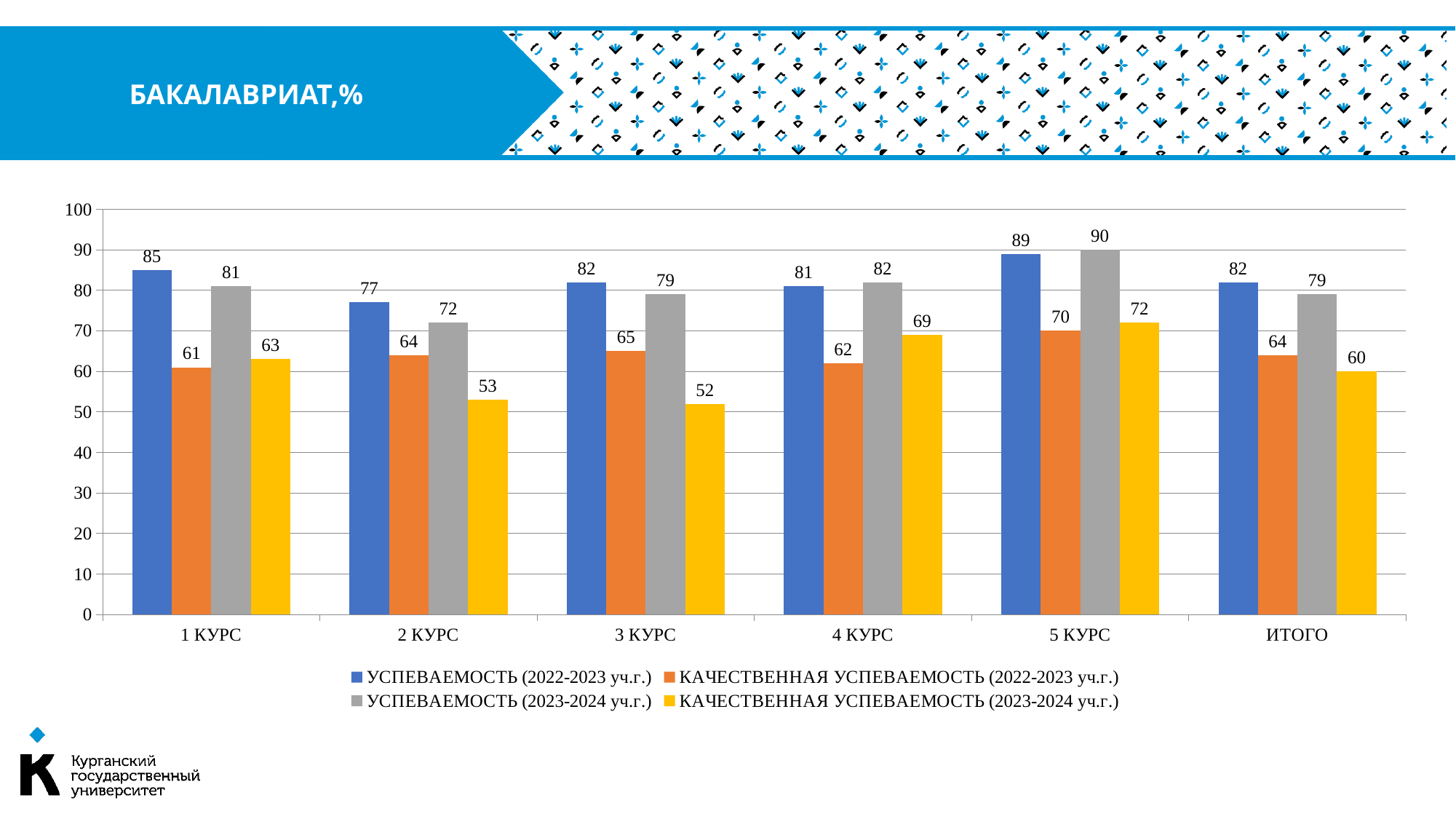
What is the value of КАЧЕСТВЕННАЯ УСПЕВАЕМОСТЬ (2023-2024 уч.г.) for 3 КУРС? 52 What is the title of the slide? БАКАЛАВРИАТ,% For 4 КУРС, which is larger: КАЧЕСТВЕННАЯ УСПЕВАЕМОСТЬ (2022-2023 уч.г.) or КАЧЕСТВЕННАЯ УСПЕВАЕМОСТЬ (2023-2024 уч.г.)? КАЧЕСТВЕННАЯ УСПЕВАЕМОСТЬ (2023-2024 уч.г.) Which category has the highest value for УСПЕВАЕМОСТЬ (2023-2024 уч.г.)? 5 КУРС What is the difference between УСПЕВАЕМОСТЬ (2022-2023 уч.г.) and КАЧЕСТВЕННАЯ УСПЕВАЕМОСТЬ (2022-2023 уч.г.) for 2 КУРС? 13 What is the value of УСПЕВАЕМОСТЬ (2023-2024 уч.г.) for ИТОГО? 79 How many series does the legend list? 4 Which category has the lowest value for КАЧЕСТВЕННАЯ УСПЕВАЕМОСТЬ (2023-2024 уч.г.)? 3 КУРС What type of chart is shown on the slide? bar chart How many categories are shown on the x axis? 6 What is the value of УСПЕВАЕМОСТЬ (2022-2023 уч.г.) for 1 КУРС? 85 What colour are the bars for КАЧЕСТВЕННАЯ УСПЕВАЕМОСТЬ (2023-2024 уч.г.)? yellow